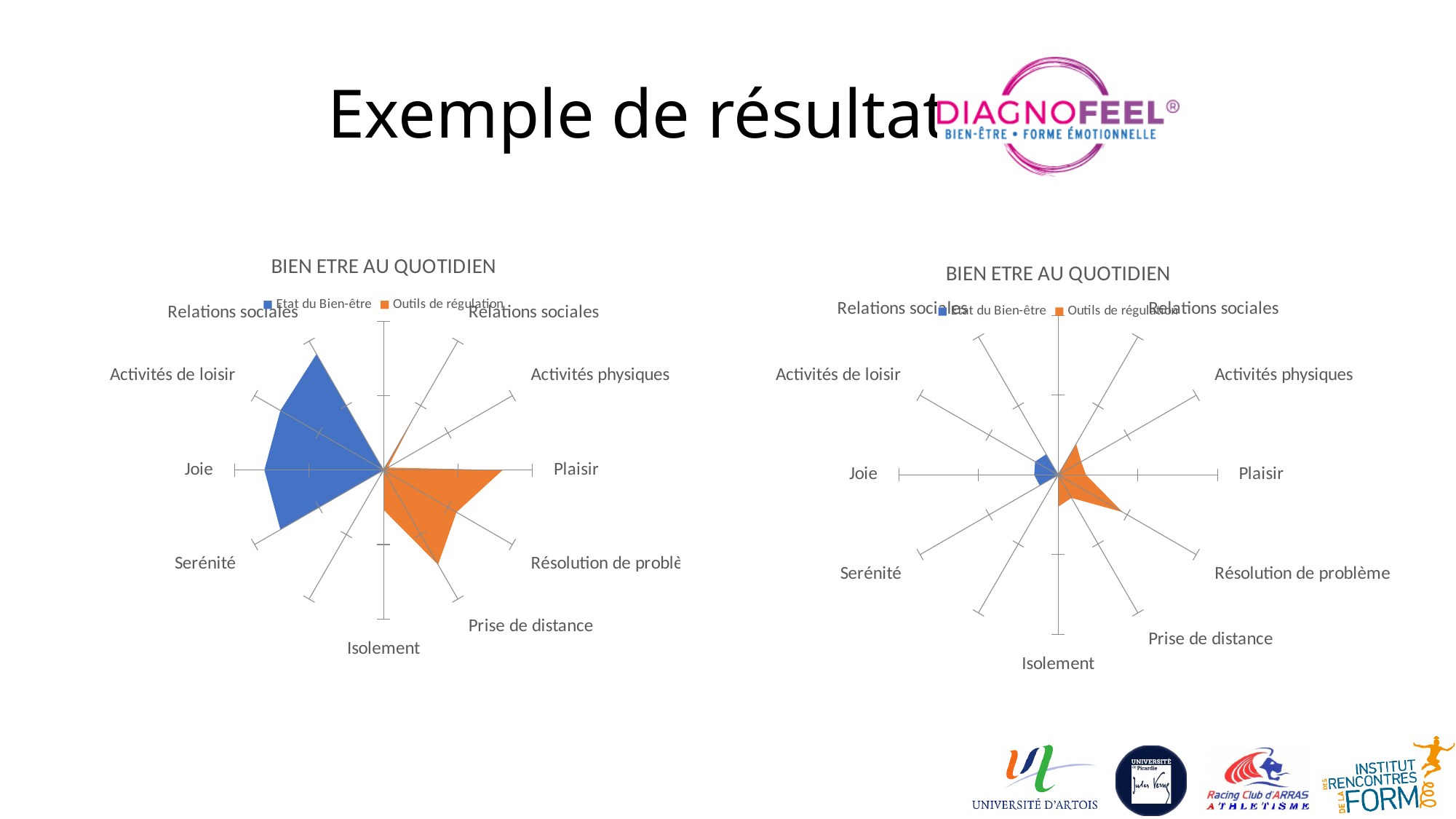
In the right chart, is the Outils de régulation value larger for Résolution de problème or for Plaisir? Résolution de problème In the left chart, is the Etat du Bien-être value larger for Joie or for Plaisir? Joie In the left chart, is the Outils de régulation value larger for Plaisir or for Joie? Plaisir In the right chart, for which category is the Outils de régulation value highest? Résolution de problème What is the title of the left chart? BIEN ETRE AU QUOTIDIEN How many series does the legend of the right chart list? 2 What kind of chart is the left chart titled BIEN ETRE AU QUOTIDIEN? Radar chart How many series does the legend of the left chart list? 2 What kind of chart is the right chart titled BIEN ETRE AU QUOTIDIEN? Radar chart In the left chart, which colour represents the series Outils de régulation? Orange